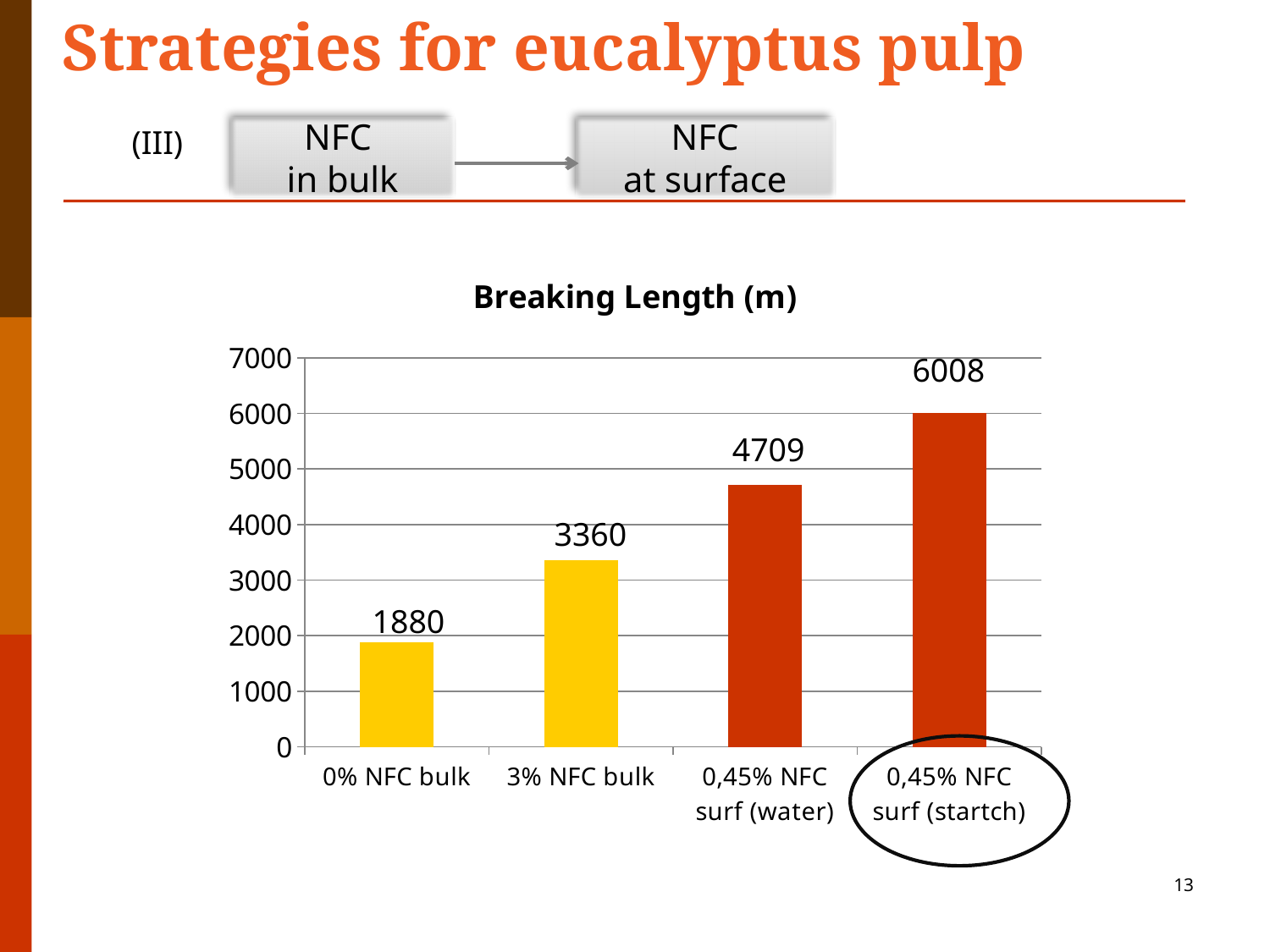
What is the breaking length for 0,45% NFC surf (water)? 4709 What is the breaking length for 0% NFC bulk? 1880 Which category has the lowest breaking length? 0% NFC bulk Which has a larger breaking length, 3% NFC bulk or 0,45% NFC surf (water)? 0,45% NFC surf (water) What is the difference in breaking length between 0,45% NFC surf (startch) and 0,45% NFC surf (water)? 1299 Do the breaking length values rise or fall from left to right along the x axis? Rise What kind of chart is shown on the slide? Bar chart What is the difference in breaking length between 3% NFC bulk and 0% NFC bulk? 1480 How many categories are shown in the chart? 4 What is the breaking length for 0,45% NFC surf (startch)? 6008 What is the breaking length for 3% NFC bulk? 3360 Which category has the highest breaking length? 0,45% NFC surf (startch)